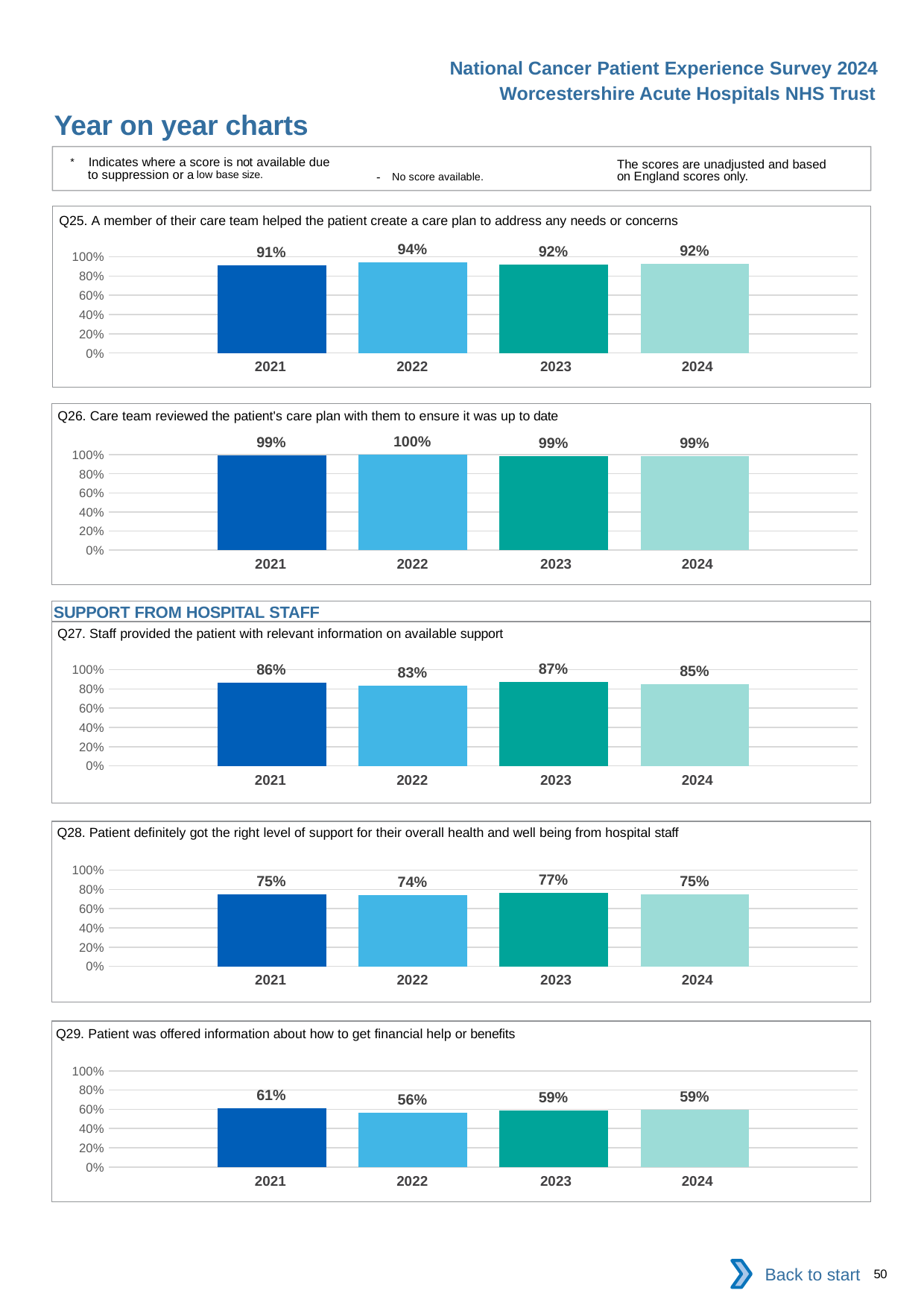
In the Q27 chart (staff provided relevant information on available support), which is larger, the value for 2021 or the value for 2024? 2021 In the Q29 chart (information about financial help or benefits), is the value for 2022 greater or less than 60%? less In the Q26 chart (care team reviewed the care plan), what is the value for 2024? 99% What type of chart is the Q28 chart (right level of support from hospital staff)? bar chart How many years are shown in the Q25 chart (care team helped create a care plan)? 4 In the Q26 chart (care team reviewed the care plan), which year has the highest value? 2022 In the Q29 chart (information about financial help or benefits), what is the value for 2021? 61% In the Q27 chart (staff provided relevant information on available support), which year has the lowest value? 2022 How many charts are shown on the slide? 5 In the Q29 chart (information about financial help or benefits), what is the difference between the 2021 and 2022 values? 5% In the Q28 chart (right level of support from hospital staff), what is the difference between the 2023 and 2022 values? 3% In the Q25 chart (care team helped create a care plan), what is the value for 2022? 94%